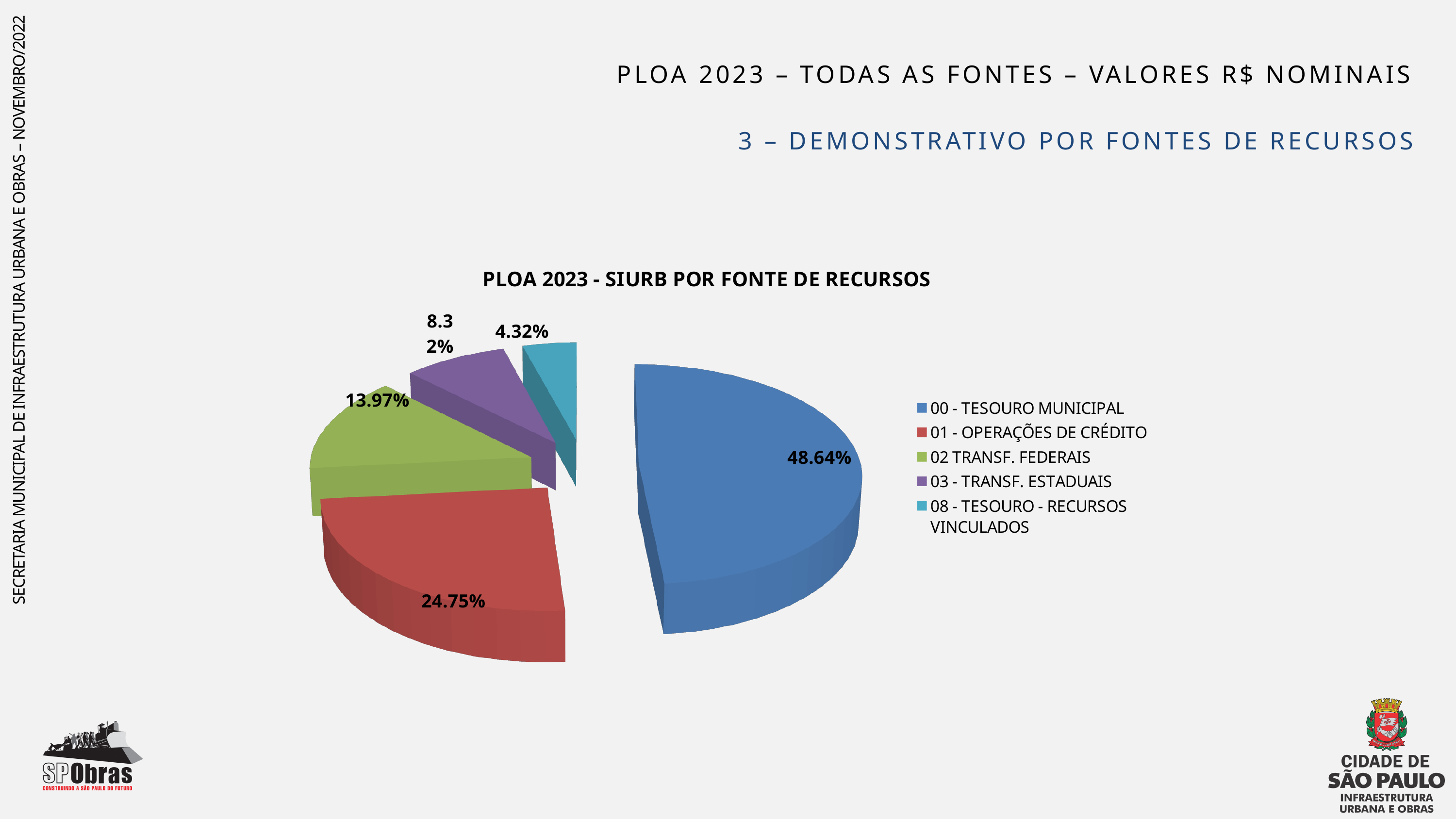
What is the value shown for 08 - TESOURO - RECURSOS VINCULADOS? 4.32% What is the title of the chart? PLOA 2023 - SIURB POR FONTE DE RECURSOS What is the value shown for 01 - OPERAÇÕES DE CRÉDITO? 24.75% Which source of funds has the largest slice of the pie? 00 - TESOURO MUNICIPAL What is the value shown for 02 TRANSF. FEDERAIS? 13.97% What share of the pie does 00 - TESOURO MUNICIPAL represent? 48.64% Which is larger, the slice for 02 TRANSF. FEDERAIS or the slice for 03 - TRANSF. ESTADUAIS? 02 TRANSF. FEDERAIS What is the difference in percentage points between 00 - TESOURO MUNICIPAL and 01 - OPERAÇÕES DE CRÉDITO? 23.89 What is the difference in percentage points between 01 - OPERAÇÕES DE CRÉDITO and 02 TRANSF. FEDERAIS? 10.78 Which source of funds has the smallest slice of the pie? 08 - TESOURO - RECURSOS VINCULADOS What type of chart is shown on the slide? Pie chart How many slices does the pie chart have? 5